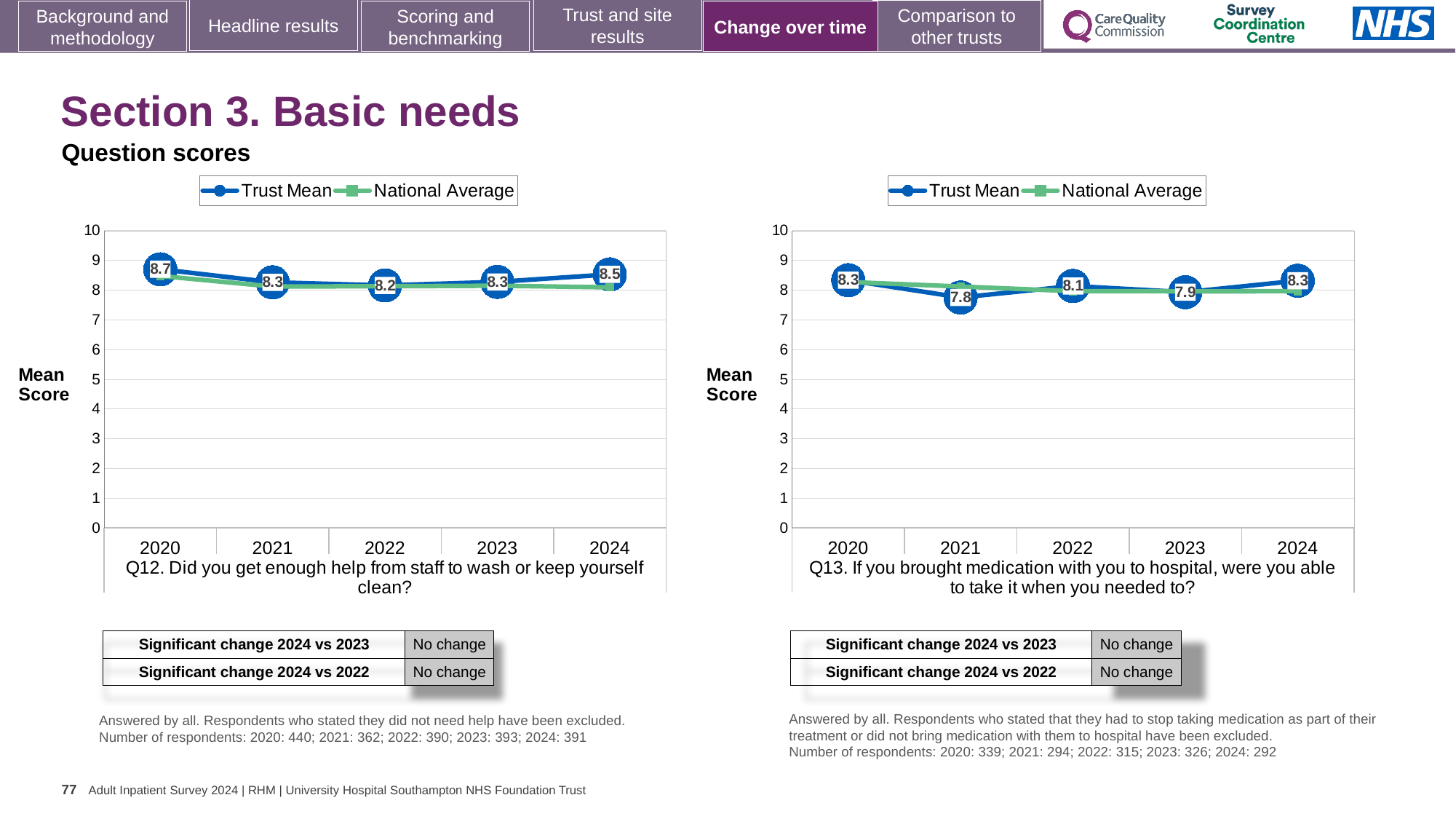
In the Q13 chart (right), what is the Trust Mean score for 2021? 7.8 What type of chart is the Q13 chart (right)? Line chart In the Q13 chart (right), is the Trust Mean score for 2022 larger or smaller than the score for 2021? larger In the Q12 chart (left), which year has the highest Trust Mean score? 2020 In the Q12 chart (left), which year has the lowest Trust Mean score? 2022 In the Q13 chart (right), what is the difference between the Trust Mean scores for 2024 and 2021? 0.5 In the Q13 chart (right), what is the Trust Mean score for 2023? 7.9 How many series does the legend of the Q12 chart (left) list? 2 In the Q12 chart (left), what is the Trust Mean score for 2024? 8.5 In the Q13 chart (right), which year has the lowest Trust Mean score? 2021 In the Q12 chart (left), what is the difference between the Trust Mean scores for 2020 and 2022? 0.5 In the Q12 chart (left), what is the Trust Mean score for 2020? 8.7